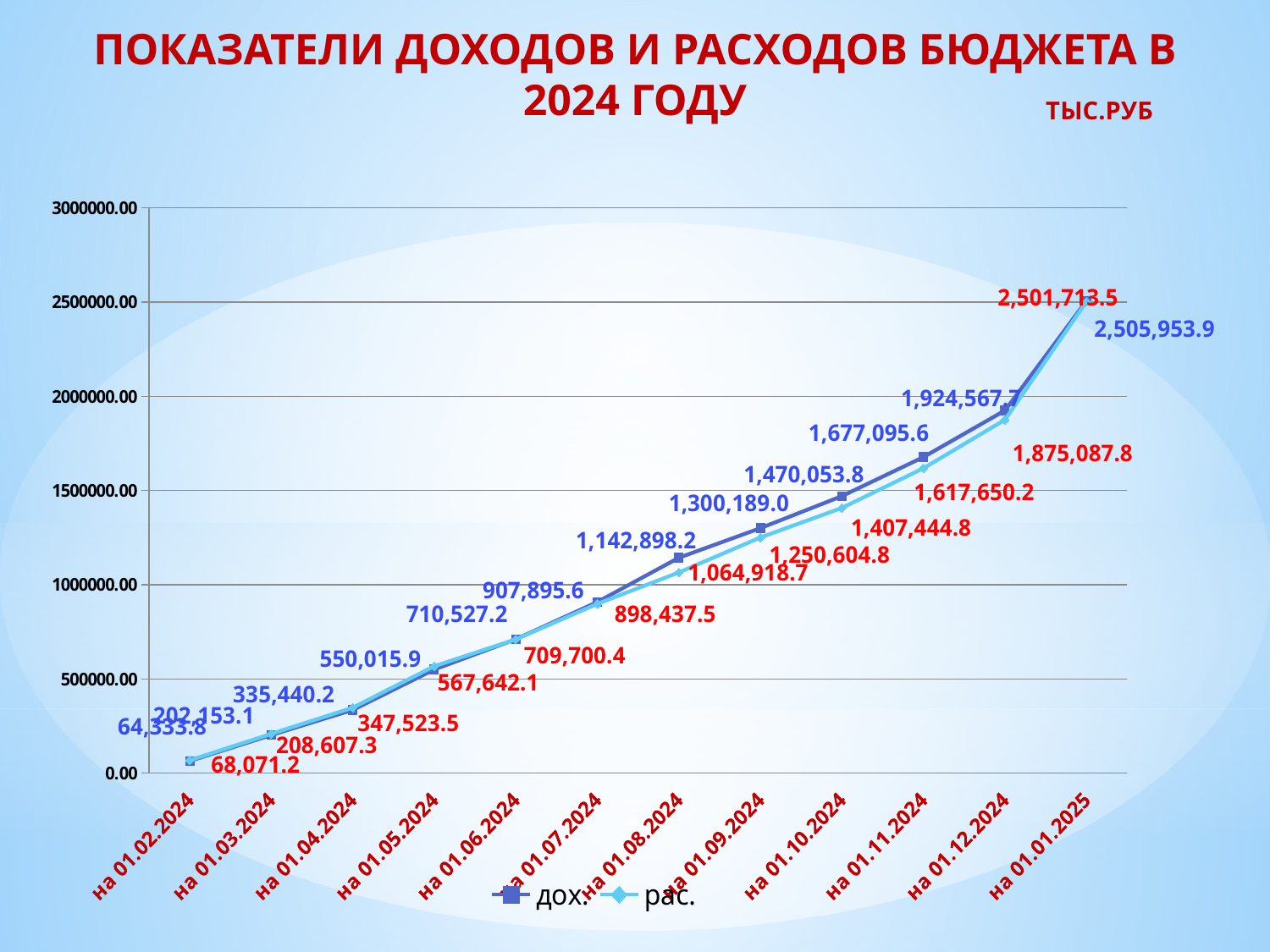
At which date is the рас. series at its lowest value? на 01.02.2024 What is the value of the дох. series at на 01.01.2025? 2,505,953.9 What kind of chart is shown on the slide? line chart What is the value of the рас. series at на 01.12.2024? 1,875,087.8 What is the value of the дох. series at на 01.08.2024? 1,142,898.2 How many dates are shown on the x axis? 12 Is the value of the дох. series at на 01.10.2024 greater or less than 1000000.00? greater What is the value of the рас. series at на 01.03.2024? 208,607.3 At which date does the дох. series reach its highest value? на 01.01.2025 Which series has the larger value at на 01.05.2024, дох. or рас.? рас. How many series does the legend list? 2 What is the difference between the дох. and рас. values at на 01.12.2024? 49,479.9